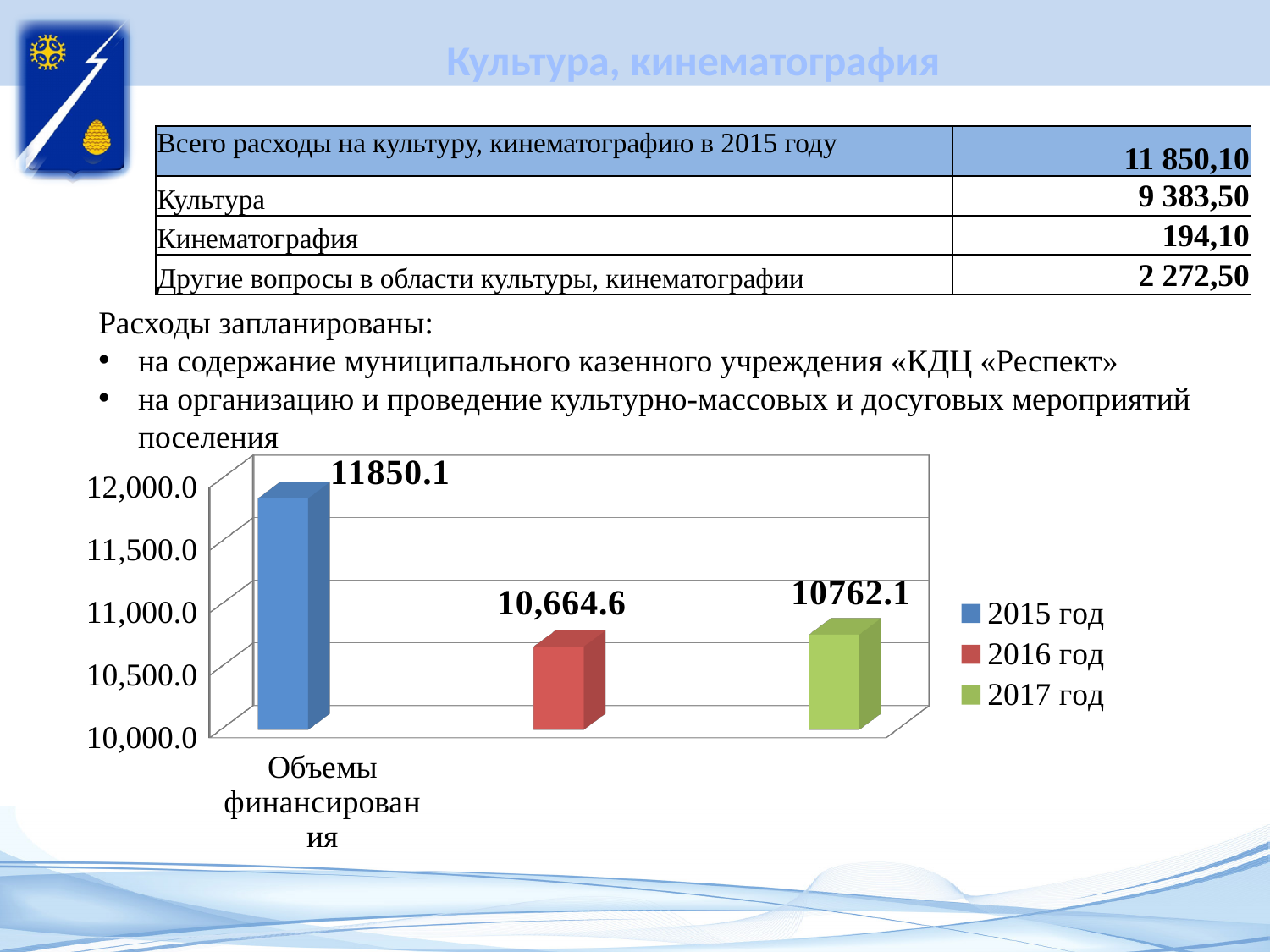
How many series does the legend list? 3 Which series has the lowest value in the chart? 2016 год Is the value for 2016 год greater or less than 11,000.0? less What kind of chart is shown on the slide? bar chart Which is larger, the value for 2015 год or the value for 2017 год? 2015 год What is the value for the 2015 год series in the chart? 11850.1 What is the category label on the x axis of the chart? Объемы финансирования What is the value for the 2016 год series in the chart? 10,664.6 What is the difference between the 2015 год value and the 2016 год value? 1185.5 What is the difference between the 2017 год value and the 2016 год value? 97.5 Which series has the highest value in the chart? 2015 год What is the value for the 2017 год series in the chart? 10762.1